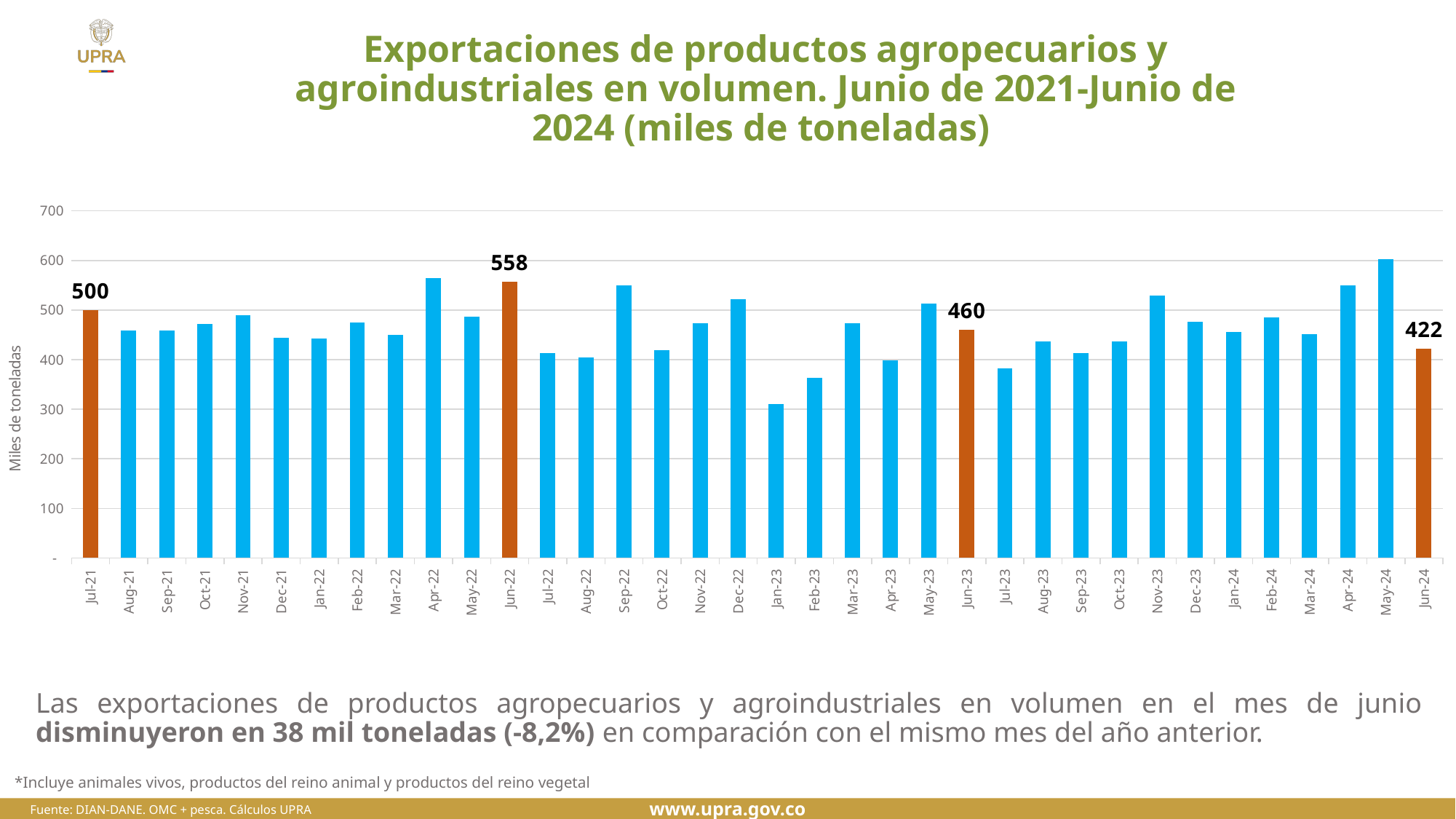
Which month has the lowest bar? Jan-23 Is the value for Jan-23 greater or less than 400? less How many months (bars) are shown on the chart? 36 What is the difference between the values for Jun-23 and Jun-24? 38 What is the value for Jun-24? 422 What is the value for Jun-23? 460 What is the value for Jul-21? 500 What is the difference between the values for Jun-22 and Jun-23? 98 Which is larger, the value for Jun-22 or the value for Jun-23? Jun-22 What is the value for Jun-22? 558 Which month has the highest bar? May-24 What kind of chart is shown on the slide? bar chart